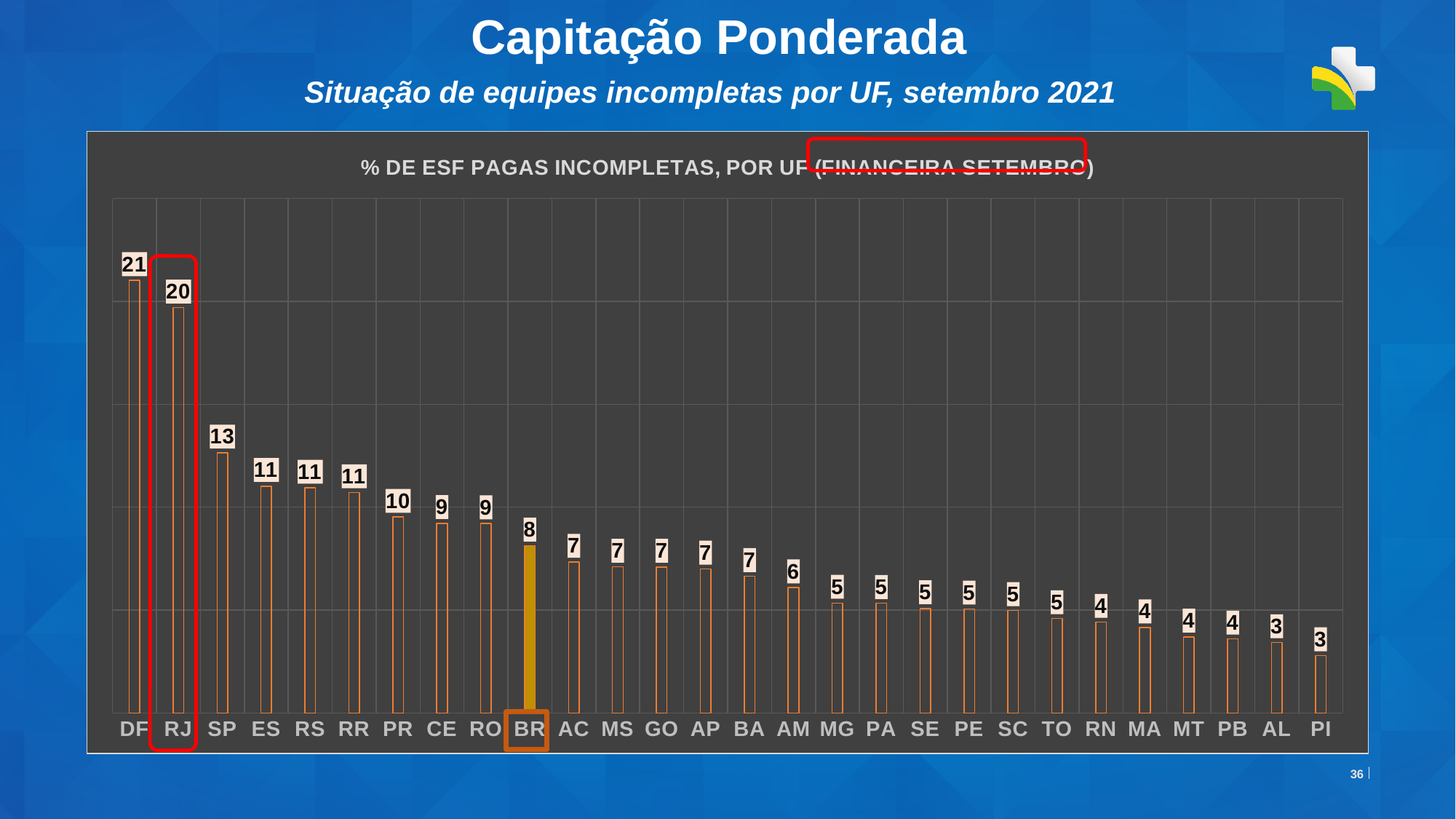
What is the value for RJ? 20 Do the values rise or fall from left to right along the x axis? Fall What is the difference between the values for DF and RJ? 1 What is the difference between the values for DF and SP? 8 What is the value for PI? 3 Which category has the highest value? DF What kind of chart is this? Bar chart What is the value for BR? 8 What is the value for DF? 21 How many categories are shown on the x axis? 28 Which is larger, the value for SP or the value for ES? SP What is the value for SP? 13